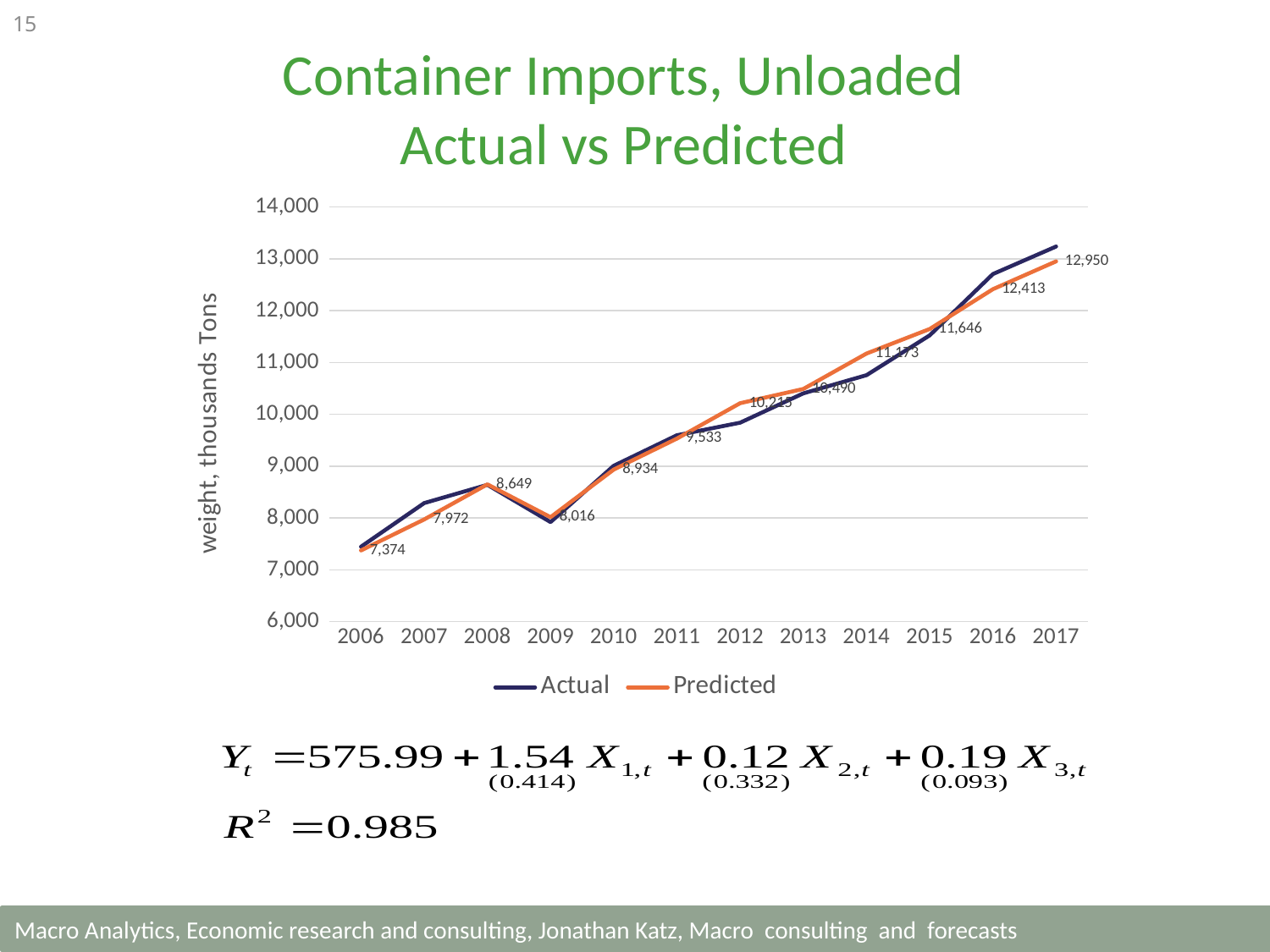
How many years are plotted along the x axis? 12 What is the title of the y axis? weight, thousands Tons What is the Predicted value labelled for 2017? 12,950 In 2007, which series has the larger value, Actual or Predicted? Actual What is the difference between the Predicted values labelled for 2017 and 2016? 537 What is the Predicted value labelled for 2008? 8,649 What is the Predicted value labelled for 2006? 7,374 Is the Actual value for 2017 greater or less than 13,000? greater What is the difference between the Predicted values labelled for 2017 and 2006? 5,576 How many series does the legend list? 2 What is the Predicted value labelled for 2016? 12,413 What kind of chart is shown on the slide? line chart